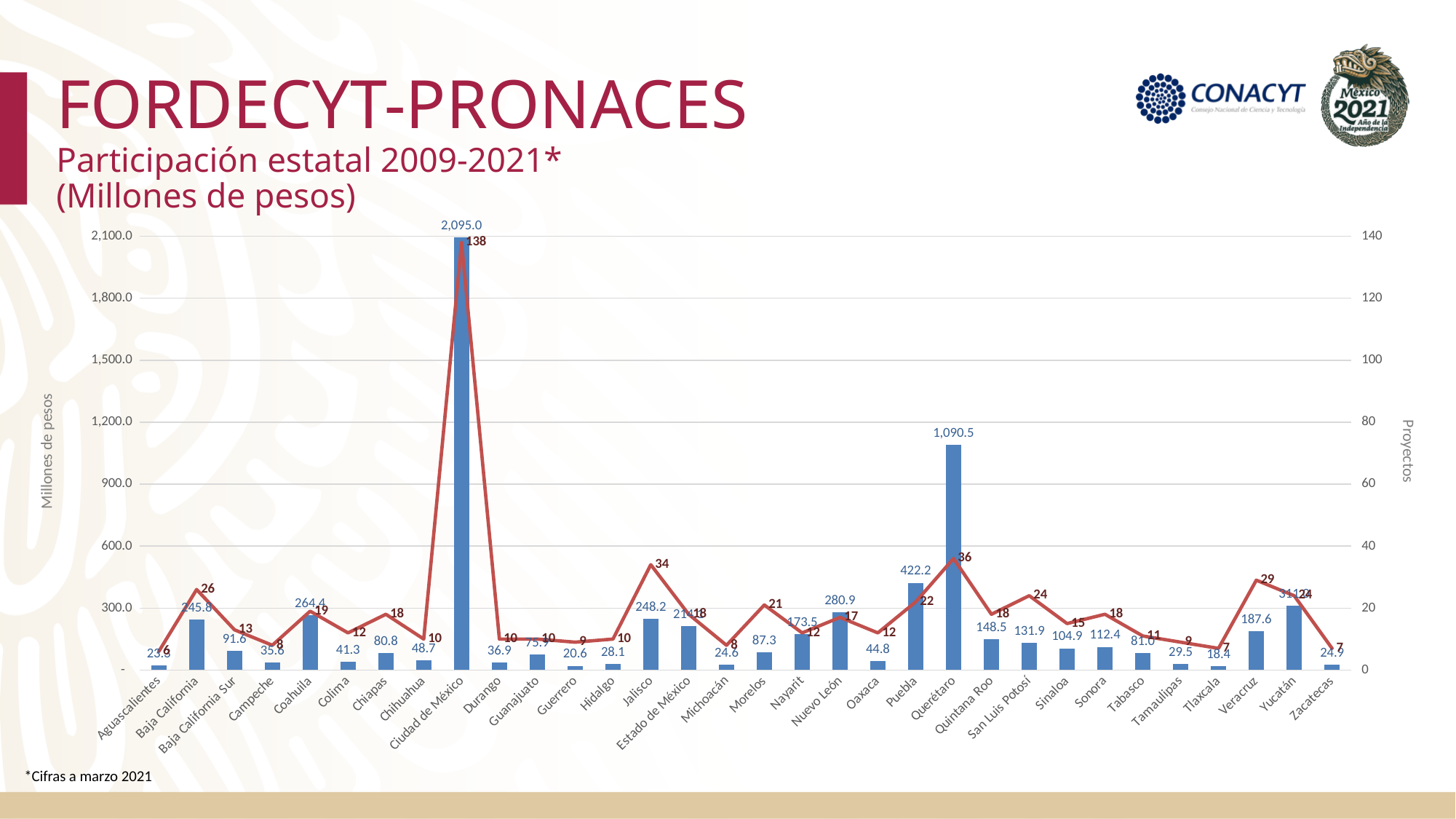
How many projects (Proyectos) does the line show for Jalisco? 34 What is the value in millions of pesos for Ciudad de México? 2,095.0 Which state has the highest value in millions of pesos? Ciudad de México What kind of chart is shown on the slide? Combined bar and line chart What is the difference in millions of pesos between Ciudad de México and Querétaro? 1,004.5 Is the value in millions of pesos for Puebla greater or less than 300.0? greater How many states are shown on the x axis? 32 Which state has the lowest value in millions of pesos? Tlaxcala What is the value in millions of pesos for Querétaro? 1,090.5 Which has a larger value in millions of pesos, Nuevo León or Jalisco? Nuevo León What is the label of the left vertical axis? Millones de pesos What is the value in millions of pesos for Puebla? 422.2